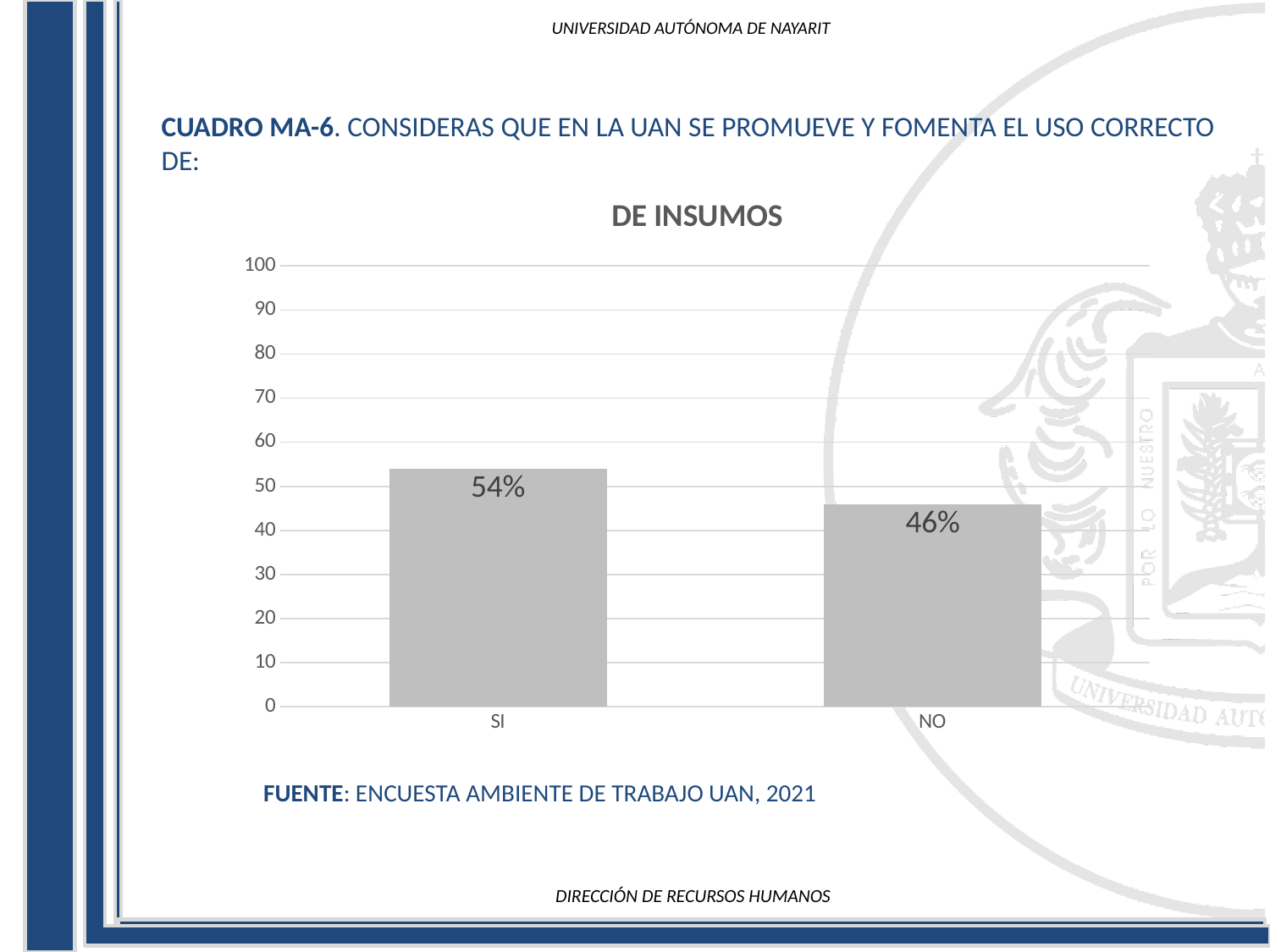
What is the title of the chart? DE INSUMOS What is the value for NO? 46% Is the value for SI greater or less than 50? greater Which category has the lowest value? NO What is the difference between the values for SI and NO? 8% What kind of chart is shown on the slide? bar chart How many categories are shown on the x axis? 2 Which category has the highest value? SI What is the value for SI? 54% Is the value for NO greater or less than 50? less What is the highest value shown on the y axis? 100 Which is larger, the value for SI or the value for NO? SI